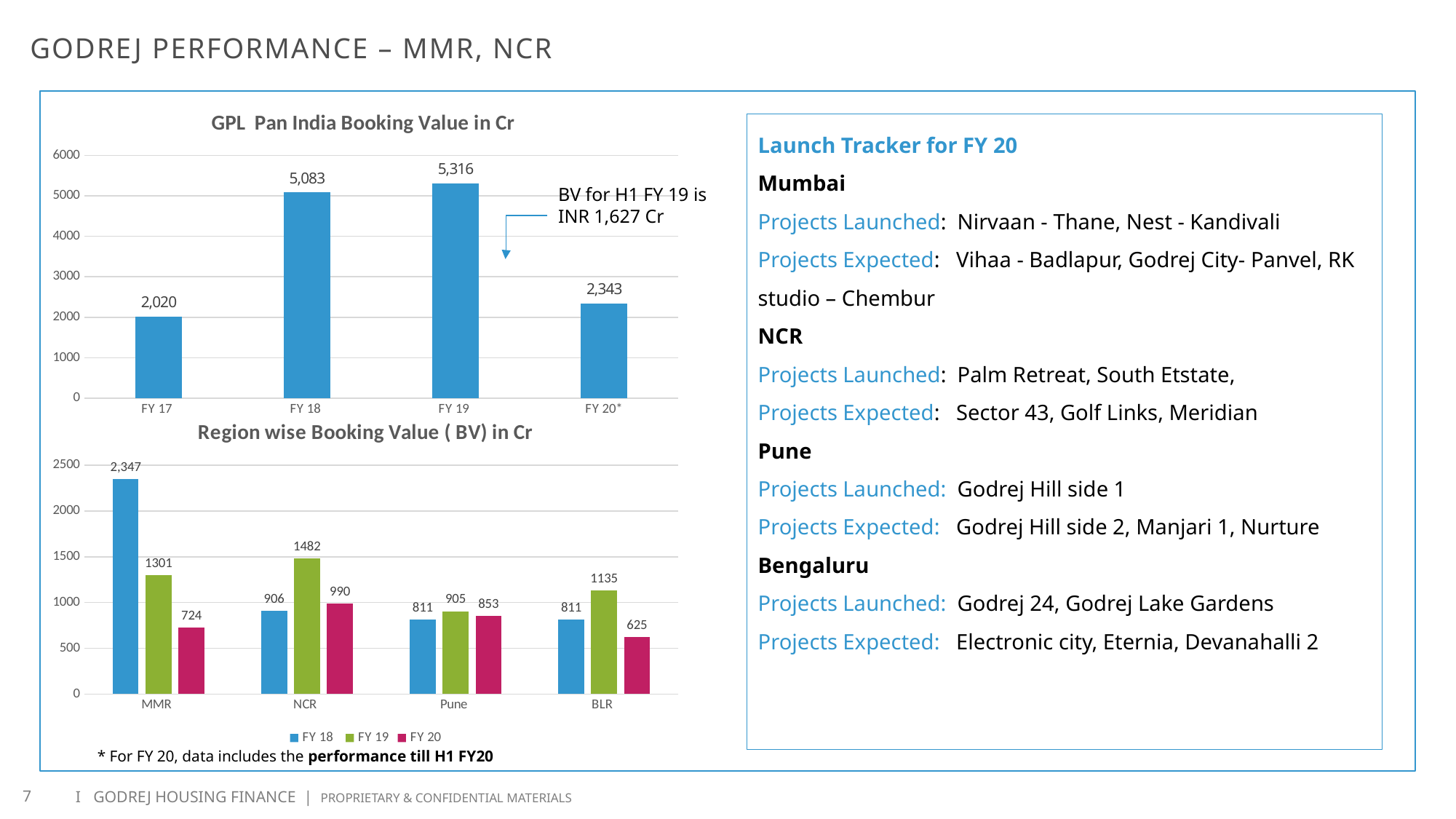
In the 'Region wise Booking Value (BV) in Cr' chart, how many series does the legend list? 3 In the 'Region wise Booking Value (BV) in Cr' chart, what is the FY 19 value for NCR? 1482 In the 'GPL Pan India Booking Value in Cr' chart, what is the value for FY 18? 5,083 What type of chart is the 'Region wise Booking Value (BV) in Cr' chart? Bar chart In the 'Region wise Booking Value (BV) in Cr' chart, what is the difference between the FY 18 and FY 19 values for MMR? 1046 In the 'GPL Pan India Booking Value in Cr' chart, which year has the highest booking value? FY 19 In the 'Region wise Booking Value (BV) in Cr' chart, which region has the highest FY 18 value? MMR In the 'Region wise Booking Value (BV) in Cr' chart, is the FY 19 value for Pune larger or the FY 20 value for Pune? FY 19 In the 'GPL Pan India Booking Value in Cr' chart, how many years are shown on the x axis? 4 In the 'Region wise Booking Value (BV) in Cr' chart, what is the FY 20 value for BLR? 625 In the 'GPL Pan India Booking Value in Cr' chart, which year has the lowest booking value? FY 17 In the 'GPL Pan India Booking Value in Cr' chart, what is the difference between the FY 19 and FY 18 values? 233